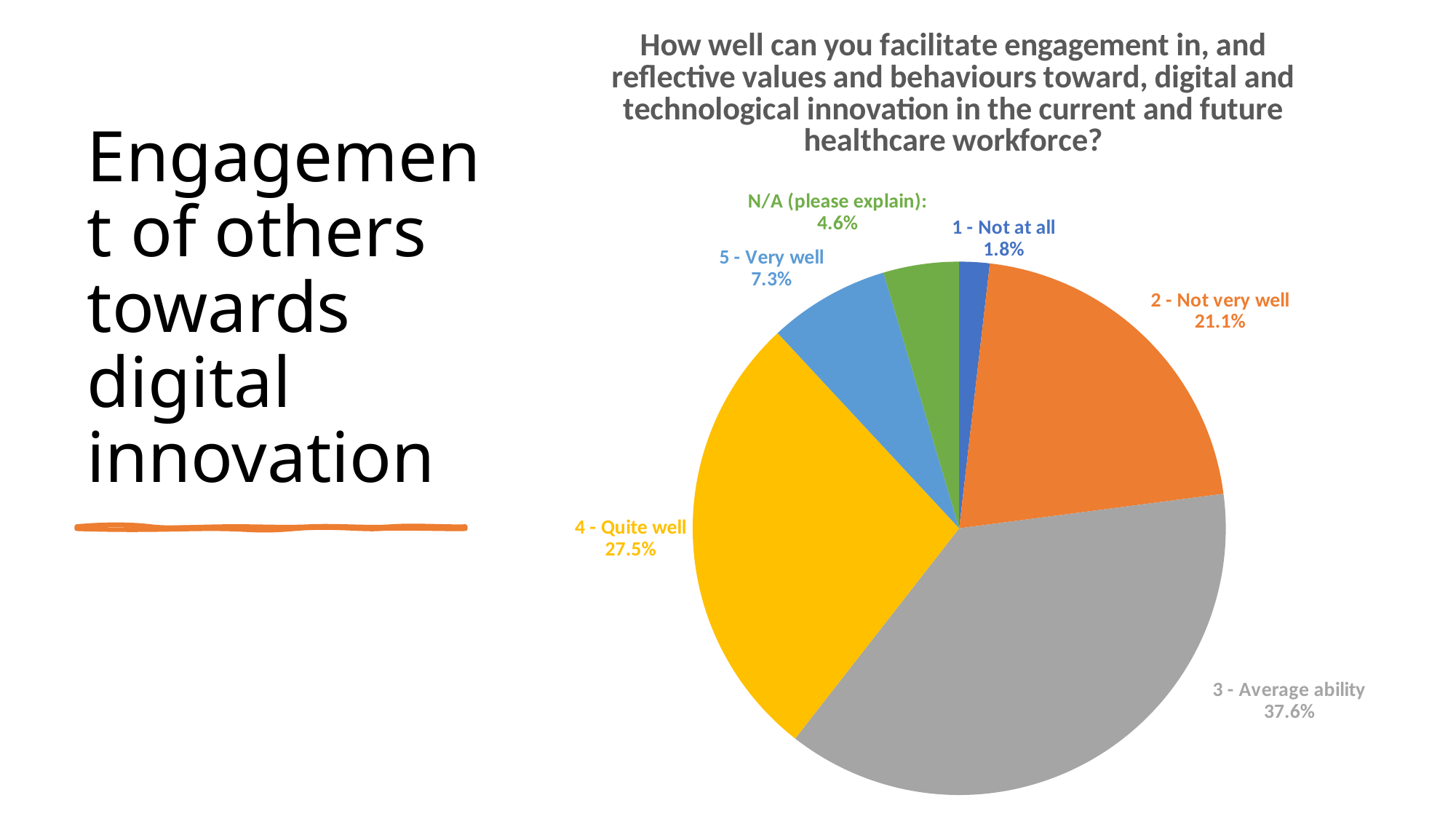
What percentage of respondents answered 'N/A (please explain):'? 4.6% What kind of chart is shown on the slide? pie chart Which response category has the smallest share of the pie? 1 - Not at all Which response category has the largest share of the pie? 3 - Average ability How many categories are shown in the pie chart? 6 What percentage of respondents answered '4 - Quite well'? 27.5% What is the difference in percentage points between '3 - Average ability' and '4 - Quite well'? 10.1 What colour is the slice for '4 - Quite well'? yellow Which is larger: the share for '2 - Not very well' or the share for '5 - Very well'? 2 - Not very well What percentage of respondents answered '1 - Not at all'? 1.8% What is the combined percentage of '5 - Very well' and 'N/A (please explain):'? 11.9% What percentage of respondents answered '3 - Average ability'? 37.6%